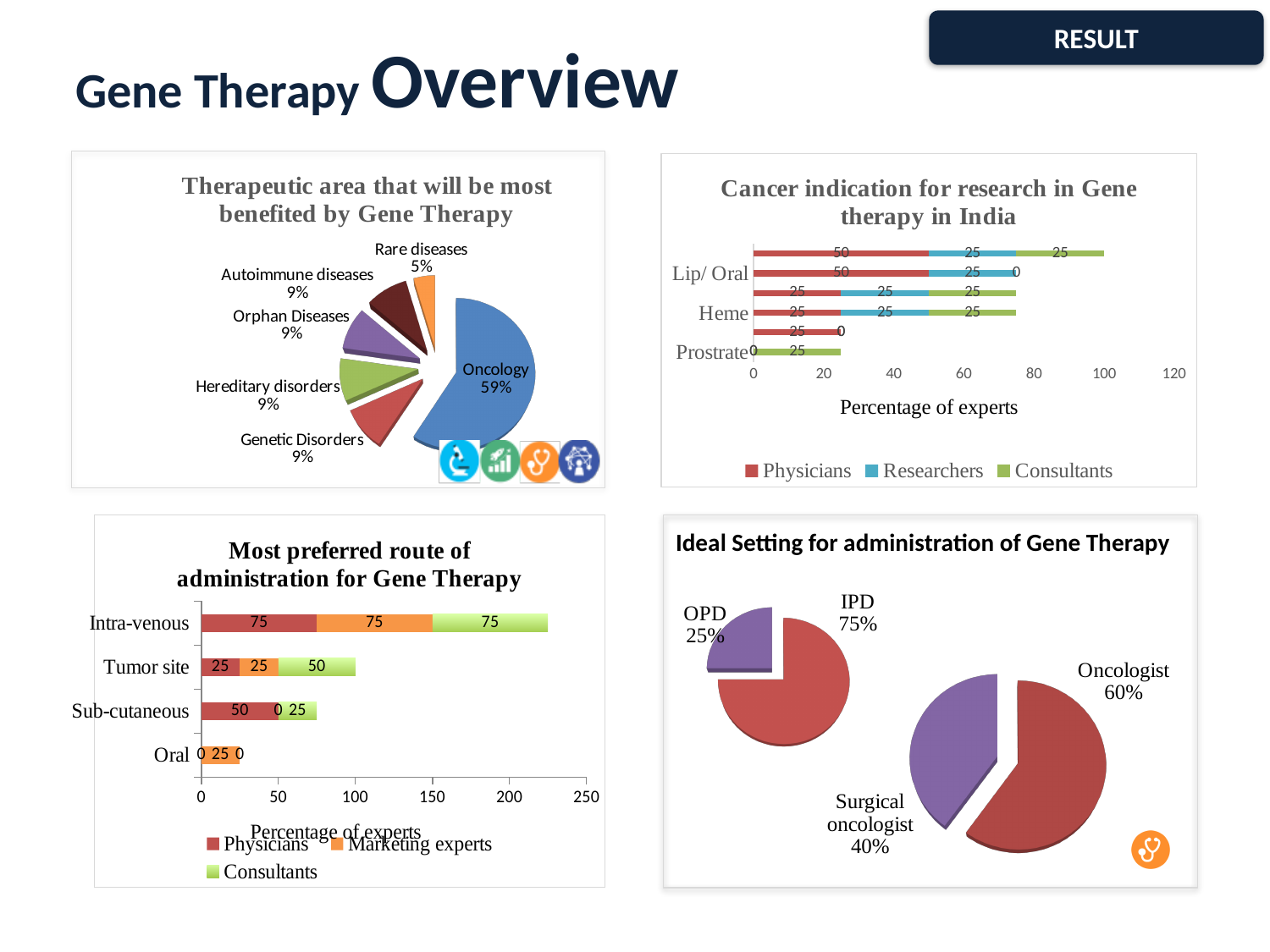
In the 'Ideal Setting for administration of Gene Therapy' chart, what share does IPD have? 75% In the 'Cancer indication for research in Gene therapy in India' chart, what is the Physicians value for Lip/ Oral? 50 In the 'Therapeutic area that will be most benefited by Gene Therapy' pie chart, which therapeutic area has the smallest share? Rare diseases How many slices does the 'Therapeutic area that will be most benefited by Gene Therapy' pie chart have? 6 In the 'Most preferred route of administration for Gene Therapy' chart, what is the Consultants value for Tumor site? 50 In the 'Therapeutic area that will be most benefited by Gene Therapy' pie chart, what is the difference between the Oncology share and the Rare diseases share? 54% In the 'Most preferred route of administration for Gene Therapy' chart, which route has the lowest total across all series? Oral What type of chart is 'Most preferred route of administration for Gene Therapy'? Bar chart In the 'Most preferred route of administration for Gene Therapy' chart, what is the total of the stacked bar for Intra-venous? 225 In the 'Therapeutic area that will be most benefited by Gene Therapy' pie chart, what share does Oncology have? 59% In the 'Cancer indication for research in Gene therapy in India' chart, what is the total of the stacked bar for Heme? 75 How many series does the legend of the 'Cancer indication for research in Gene therapy in India' chart list? 3